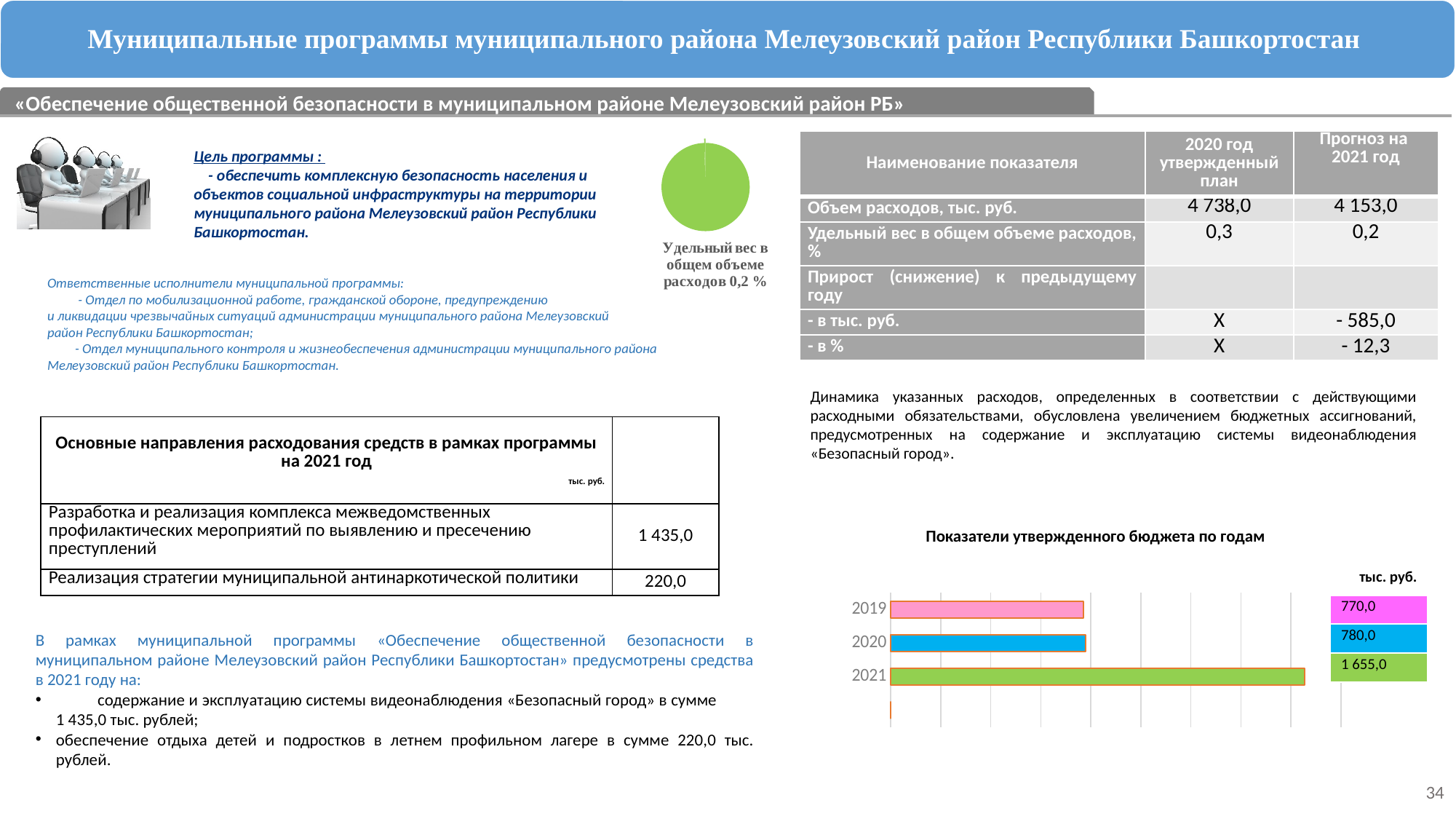
In the chart "Показатели утвержденного бюджета по годам", what is the difference between the values for 2020 and 2019? 10,0 In the chart "Показатели утвержденного бюджета по годам", what is the value for 2019? 770,0 In the chart "Показатели утвержденного бюджета по годам", which is larger, the value for 2021 or the value for 2019? 2021 What kind of chart is "Показатели утвержденного бюджета по годам"? bar chart In the chart "Показатели утвержденного бюджета по годам", what is the value for 2021? 1 655,0 What unit is indicated for the chart "Показатели утвержденного бюджета по годам"? тыс. руб. In the chart "Показатели утвержденного бюджета по годам", do the values rise or fall from 2019 to 2021? rise How many years are shown in the chart "Показатели утвержденного бюджета по годам"? 3 In the chart "Показатели утвержденного бюджета по годам", what is the value for 2020? 780,0 In the chart "Показатели утвержденного бюджета по годам", which year has the highest value? 2021 What share is stated in the caption of the green pie chart ("Удельный вес в общем объеме расходов")? 0,2 % In the chart "Показатели утвержденного бюджета по годам", what is the difference between the values for 2021 and 2020? 875,0